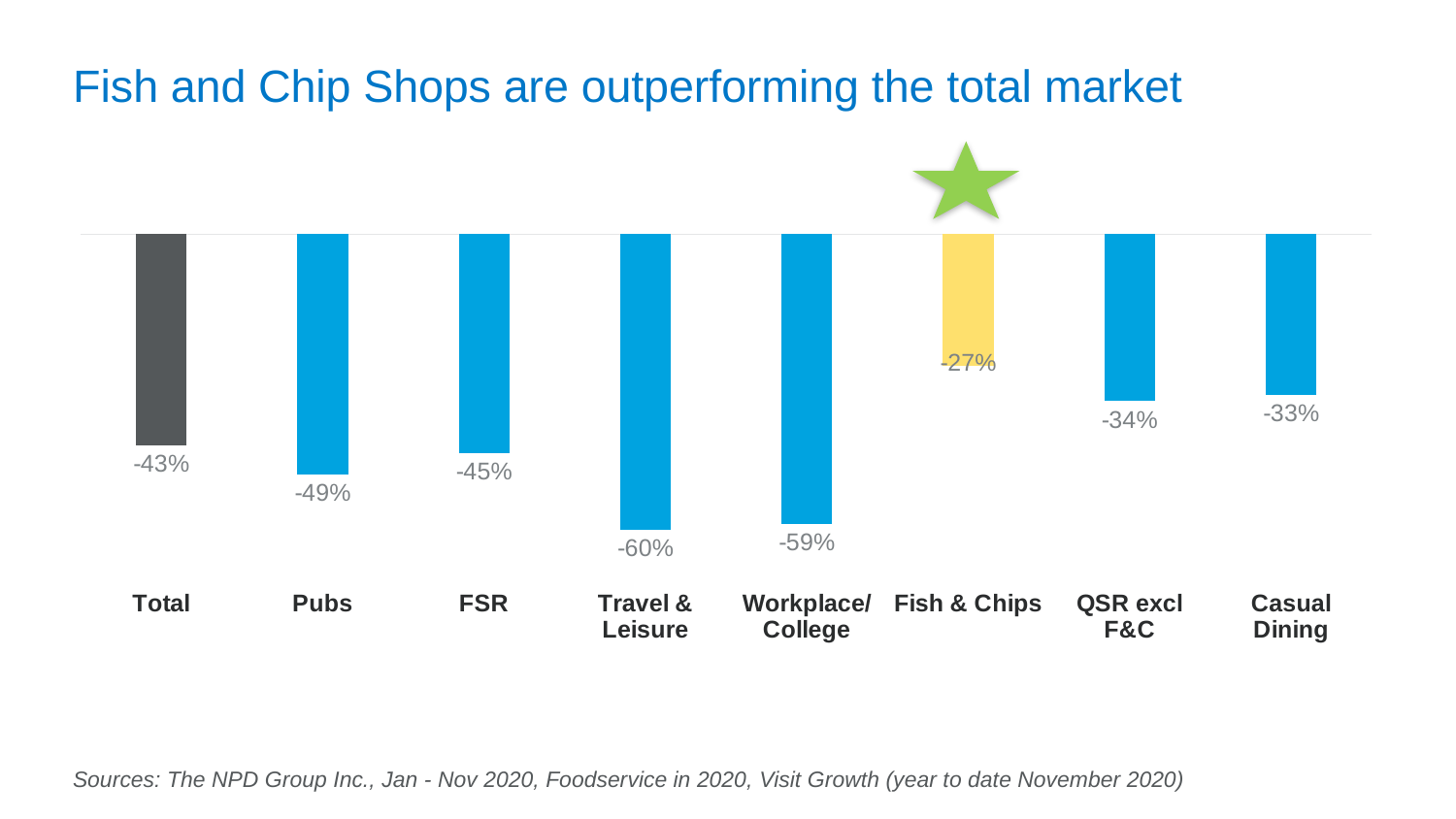
How many categories are shown in the chart? 8 Which category's bar is coloured yellow and marked with a star? Fish & Chips Which category has the highest (least negative) value? Fish & Chips Which category has the lowest (most negative) value? Travel & Leisure What is the difference in percentage points between the Pubs value and the FSR value? 4 percentage points What is the value shown for Travel & Leisure? -60% What is the value shown for QSR excl F&C? -34% What is the value shown for Fish & Chips? -27% What is the value shown for Total? -43% What is the difference in percentage points between the Fish & Chips value and the Total value? 16 percentage points Which has the higher (less negative) value, Casual Dining or Pubs? Casual Dining What kind of chart is shown on the slide? Bar chart